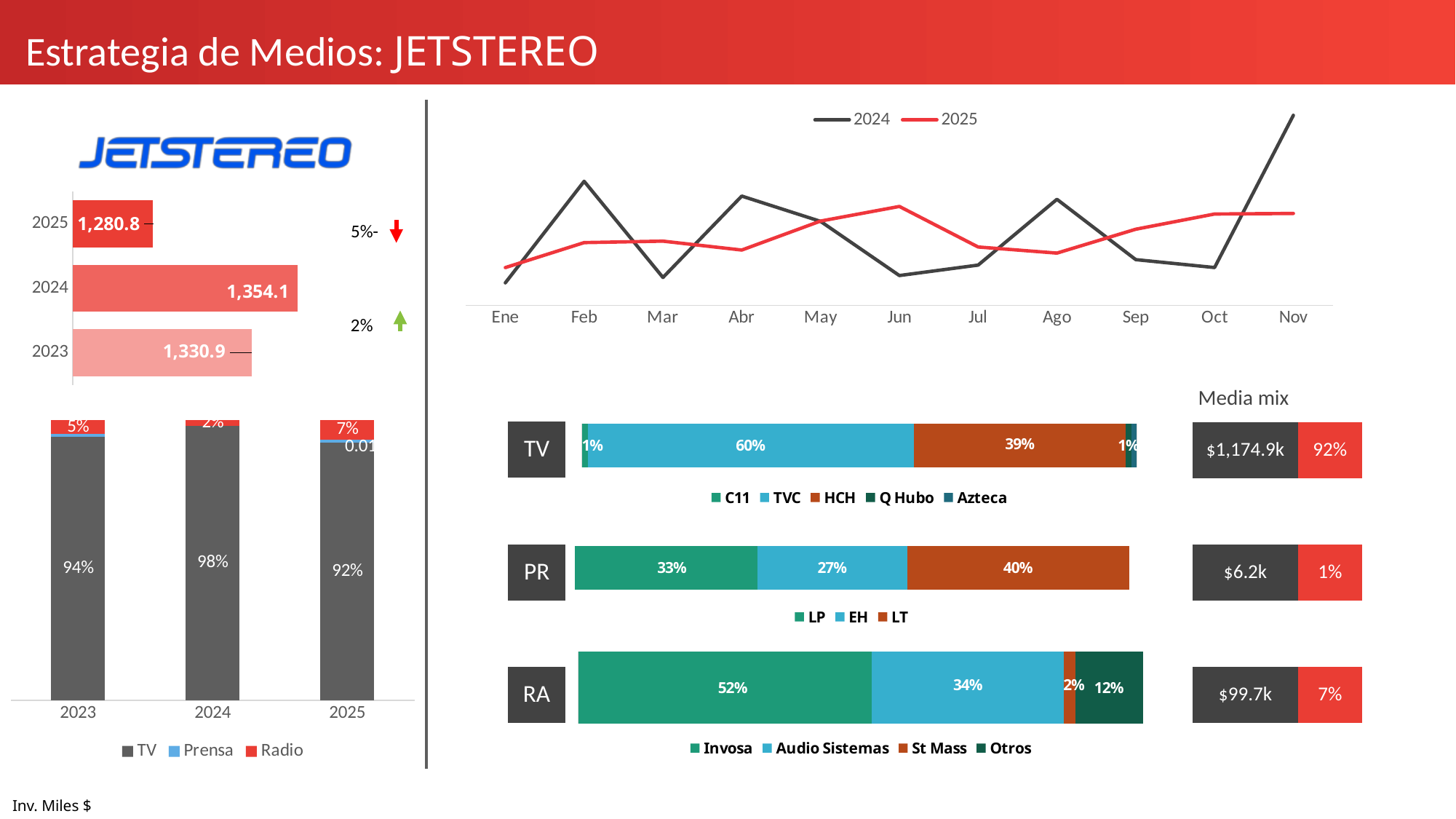
What kind of chart is the monthly chart at the top right comparing 2024 and 2025? Line chart In the TV stacked bar on the right, what is the share for TVC? 60% In the stacked bar chart at the bottom left, what is the TV share for 2025? 92% In the PR stacked bar on the right, which segment is the largest? LT In the horizontal bar chart of yearly investment on the left, what is the value for 2024? 1,354.1 In the monthly line chart at the top right, which series is higher in Nov, 2024 or 2025? 2024 In the stacked bar chart at the bottom left, how many series does the legend list? 3 In the monthly line chart at the top right, how many months are shown on the x axis? 11 In the horizontal bar chart of yearly investment on the left, which is larger, the value for 2023 or for 2025? 2023 In the Media mix section, what is the amount shown for RA? $99.7k In the horizontal bar chart of yearly investment on the left, what is the difference between the 2024 and 2023 values? 23.2 In the horizontal bar chart of yearly investment on the left, which year has the highest value? 2024